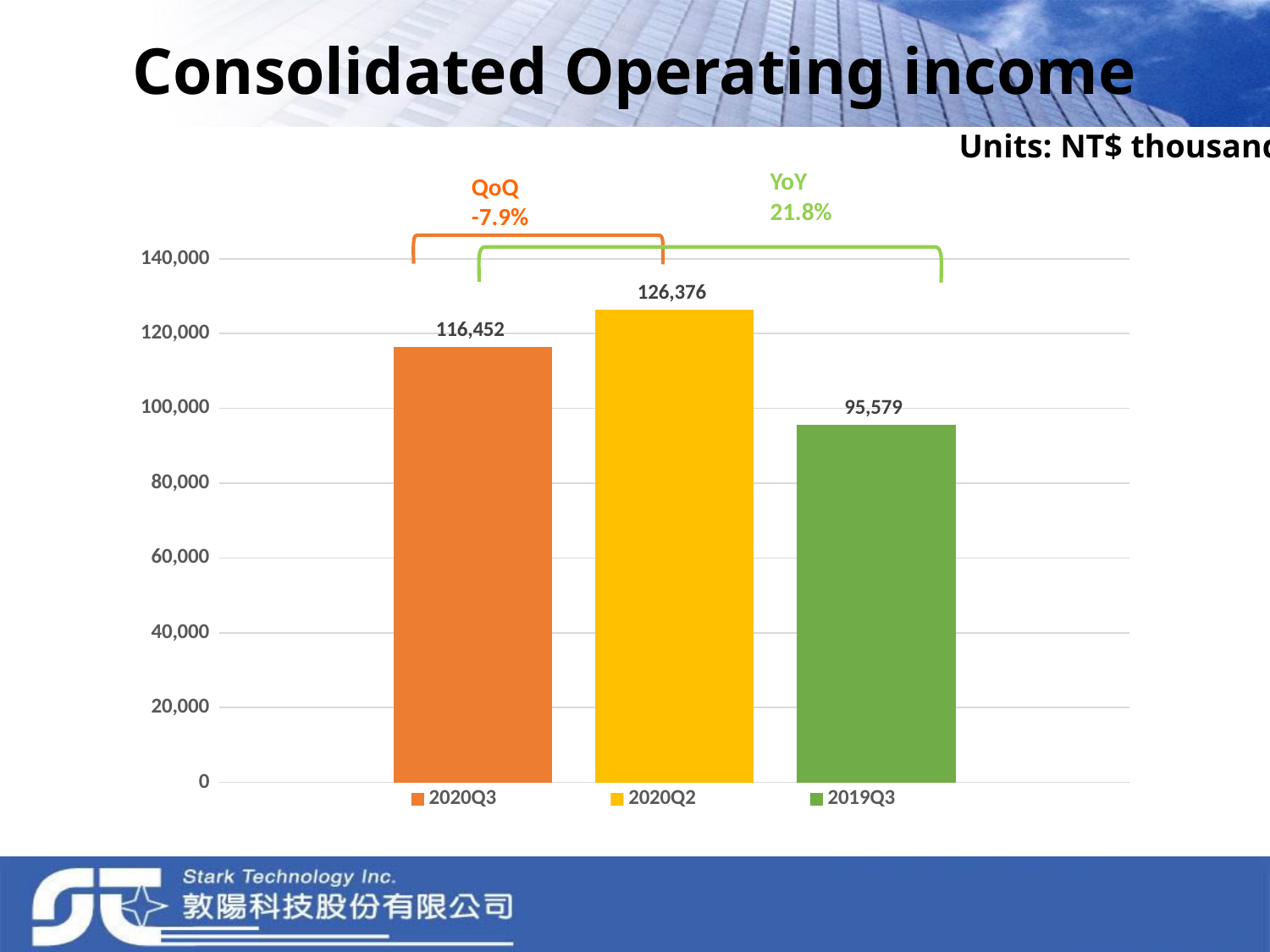
What type of chart is shown on the slide? bar chart Which quarter has the highest consolidated operating income? 2020Q2 What QoQ percentage change is shown on the chart? -7.9% What is the difference in operating income between 2020Q3 and 2019Q3? 20,873 Is the value for 2019Q3 greater or less than 100,000? less Which is larger, the operating income for 2020Q3 or for 2019Q3? 2020Q3 What is the consolidated operating income for 2019Q3? 95,579 What is the consolidated operating income for 2020Q3? 116,452 Which quarter has the lowest consolidated operating income? 2019Q3 How many bars are shown in the chart? 3 What is the consolidated operating income for 2020Q2? 126,376 What is the difference in operating income between 2020Q2 and 2020Q3? 9,924